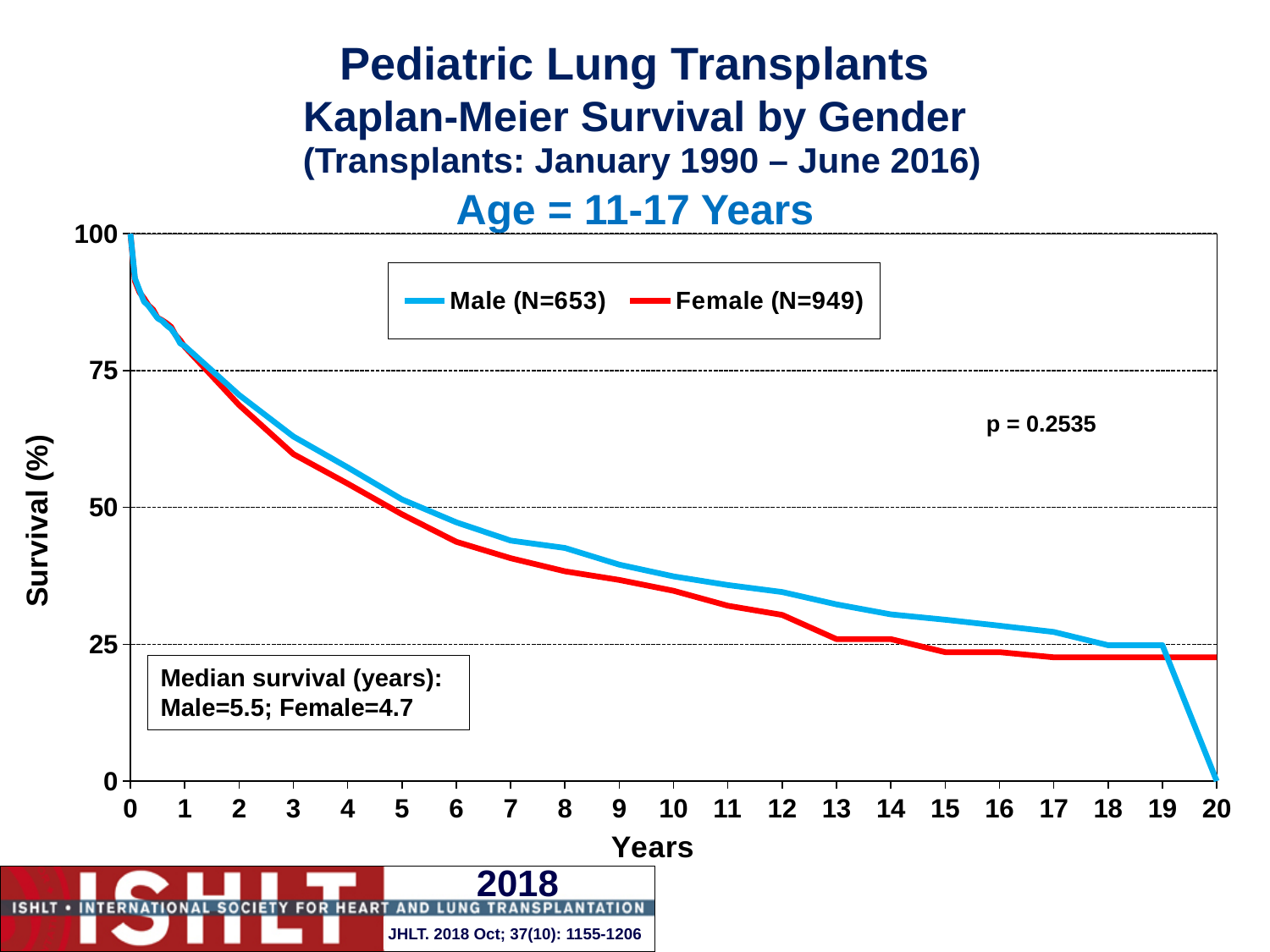
What survival value does the Male curve reach at year 20? 0 How many series does the legend list? 2 What is the survival value for both Male and Female at year 0? 100 What type of chart is shown on the slide? Line chart What is the median survival in years for Female according to the text box? 4.7 Is the Male survival value at year 13 greater or less than 25? greater What is the N for the Male series shown in the legend? N=653 Is the Male survival value at year 10 greater or less than 50? less Is the Female survival value at year 6 greater or less than 50? less Do the survival curves rise or fall as years increase? Fall At year 13, which series has the higher survival value, Male or Female? Male